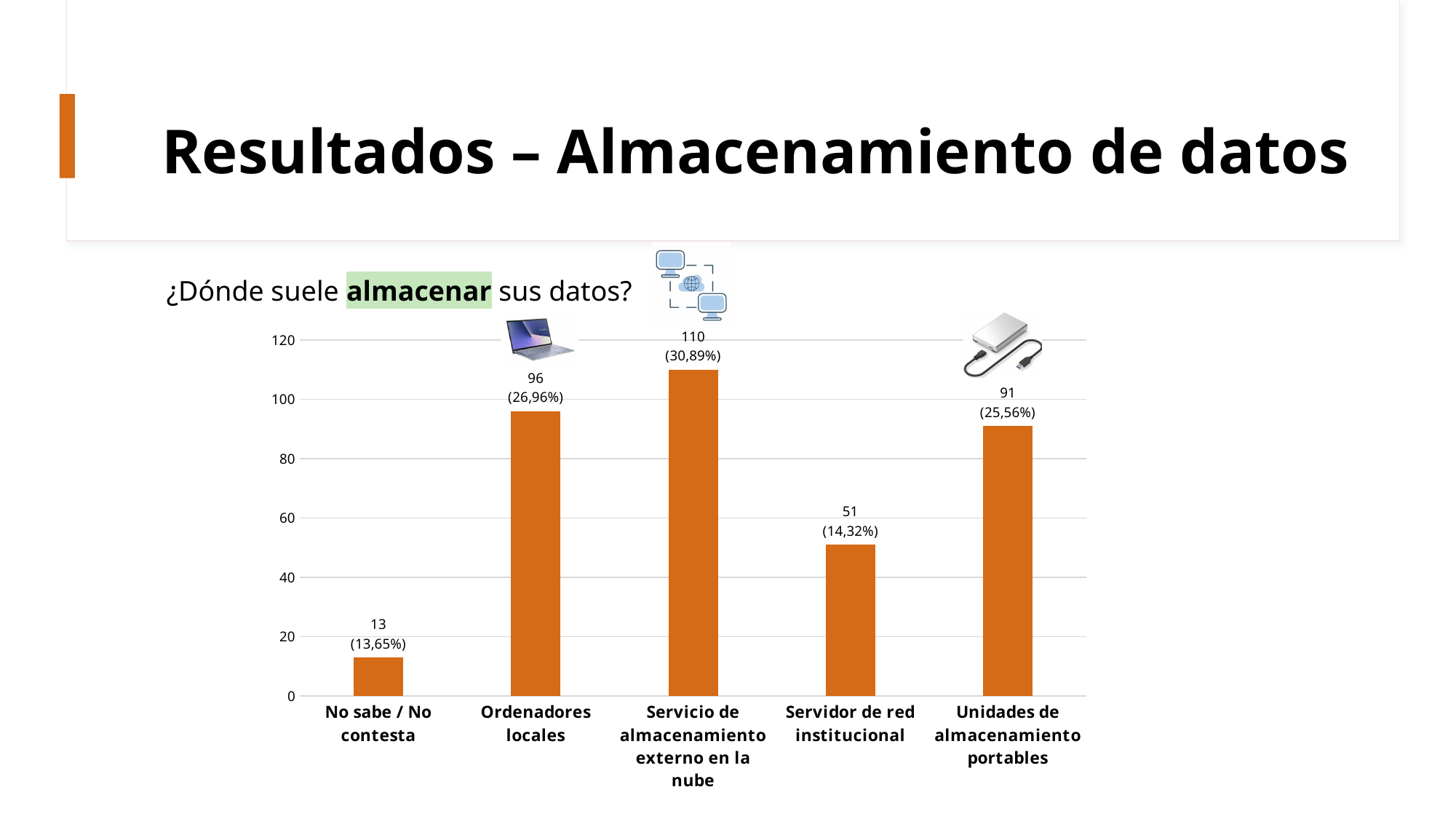
What kind of chart is shown on the slide? bar chart What is the difference between the values for Servicio de almacenamiento externo en la nube and Ordenadores locales? 14 What percentage is shown for Unidades de almacenamiento portables? 25,56% Which category has the highest value? Servicio de almacenamiento externo en la nube What question does the chart answer, as written above it? ¿Dónde suele almacenar sus datos? Which is larger, the value for Ordenadores locales or the value for Unidades de almacenamiento portables? Ordenadores locales What is the value for Servidor de red institucional? 51 What is the value for No sabe / No contesta? 13 Which category has the lowest value? No sabe / No contesta How many categories are shown on the x axis? 5 Is the value for Servidor de red institucional greater or less than 60? less What is the value for Ordenadores locales? 96